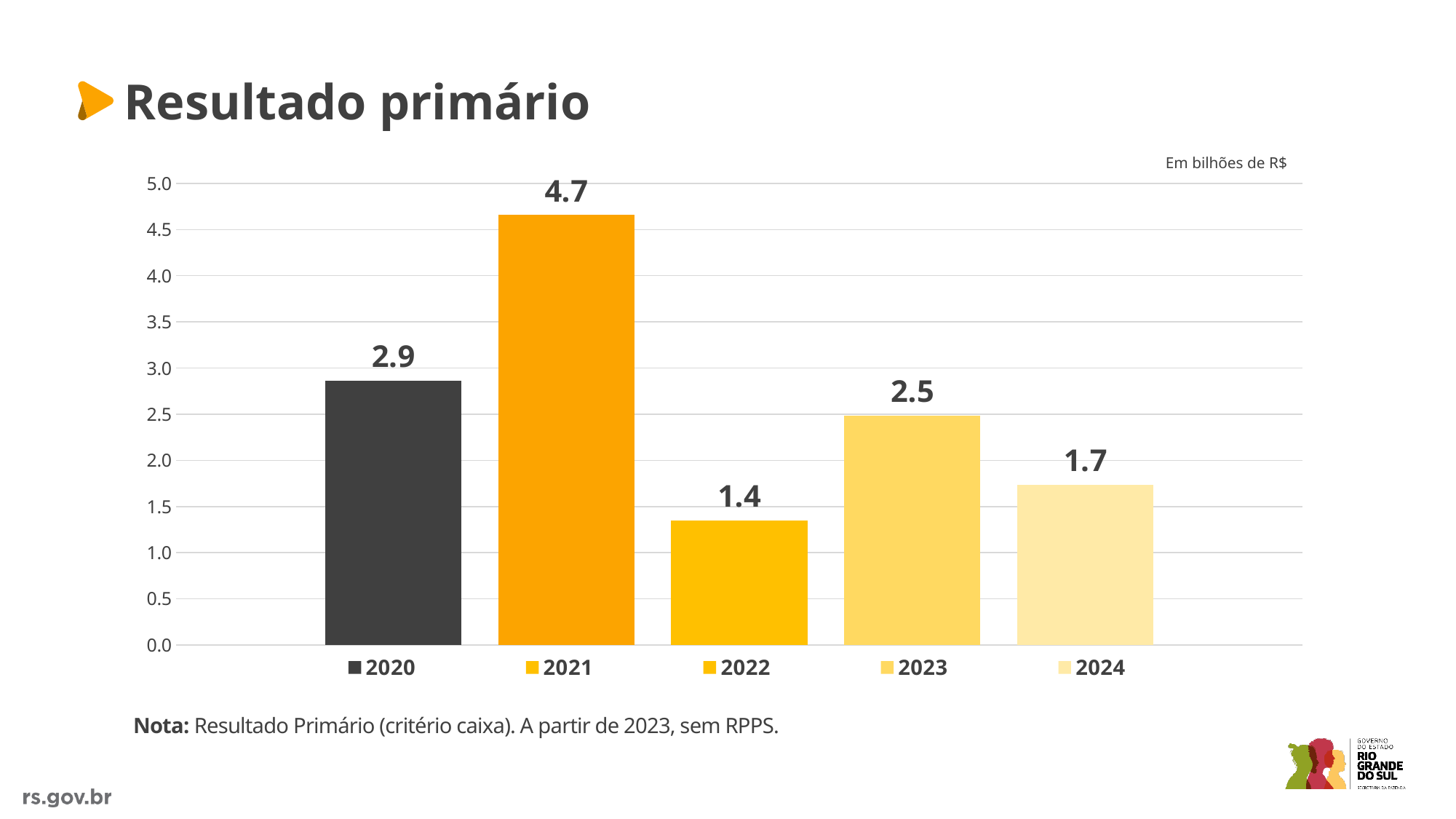
How many years are shown in the chart? 5 What kind of chart is shown on the slide? bar chart What is the title of the slide? Resultado primário Which is larger, the value for 2020 or the value for 2023? 2020 What is the difference between the values for 2021 and 2020? 1.8 What is the difference between the values for 2023 and 2024? 0.8 What is the value for 2022? 1.4 What is the value for 2021? 4.7 Which year has the highest value? 2021 What is the value for 2024? 1.7 Is the value for 2023 greater or less than 2.0? greater Which year has the lowest value? 2022